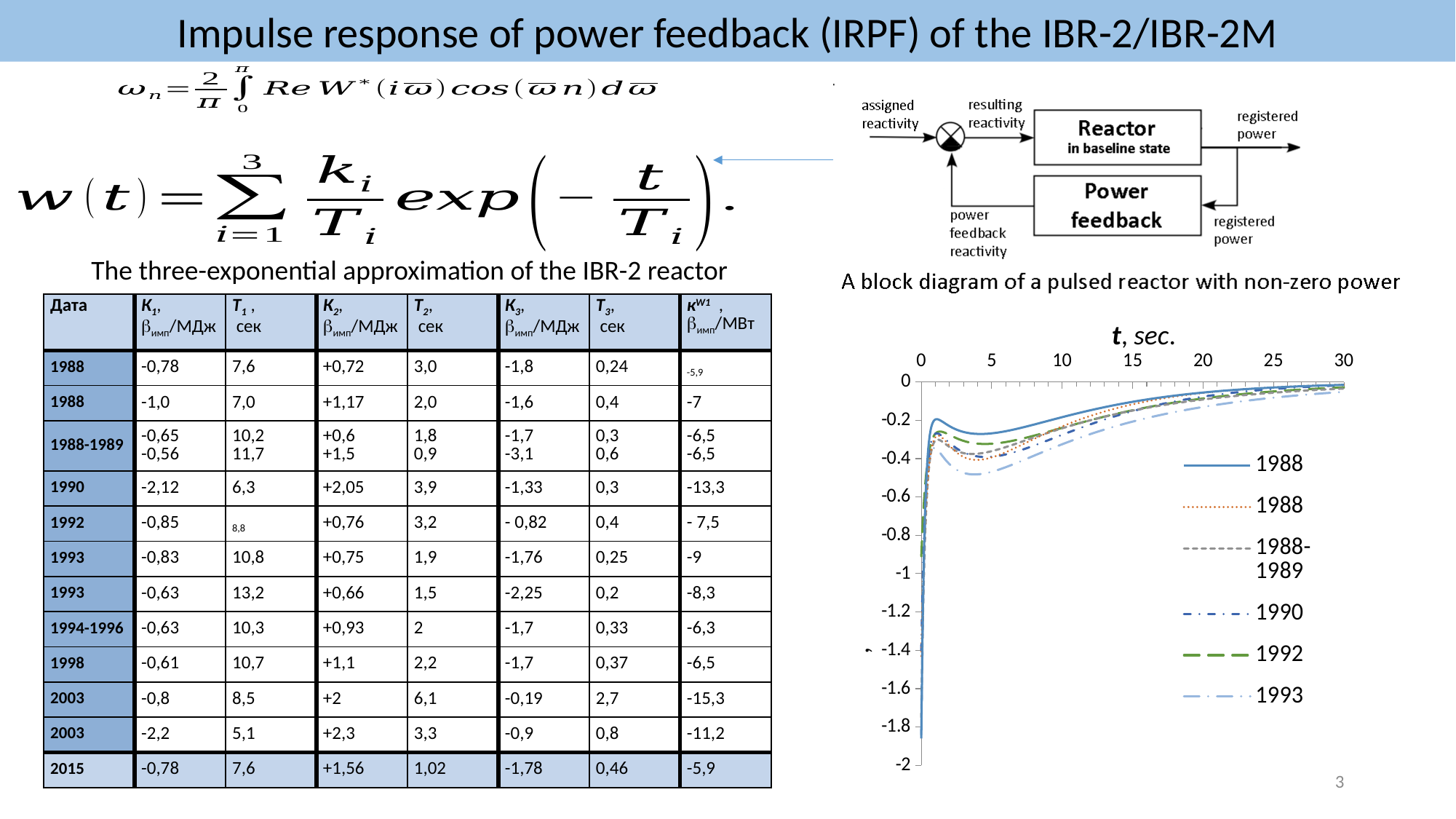
Which legend entry of the line chart is drawn as a solid line? 1988 What is the largest value shown on the x axis of the line chart? 30 In the line chart, which series has the highest value around t = 5 sec? 1988 (solid line) What kind of chart is shown on the right side of the slide? line chart How many series does the legend of the line chart list? 6 In the line chart, is the value of the 1990 series at t = 30 sec greater or less than -0.2? greater What is the lowest value shown on the y axis of the line chart? -2 In the line chart, is the value of the 1993 series at t = 5 sec greater or less than -0.4? less In the line chart, is the value of the solid 1988 series at t = 5 sec greater or less than -0.4? greater What is the label of the x axis of the line chart? t, sec. In the line chart, do the curves rise or fall as t increases from 5 sec to 30 sec? rise In the line chart, which series reaches the lowest value around t = 5 sec? 1993